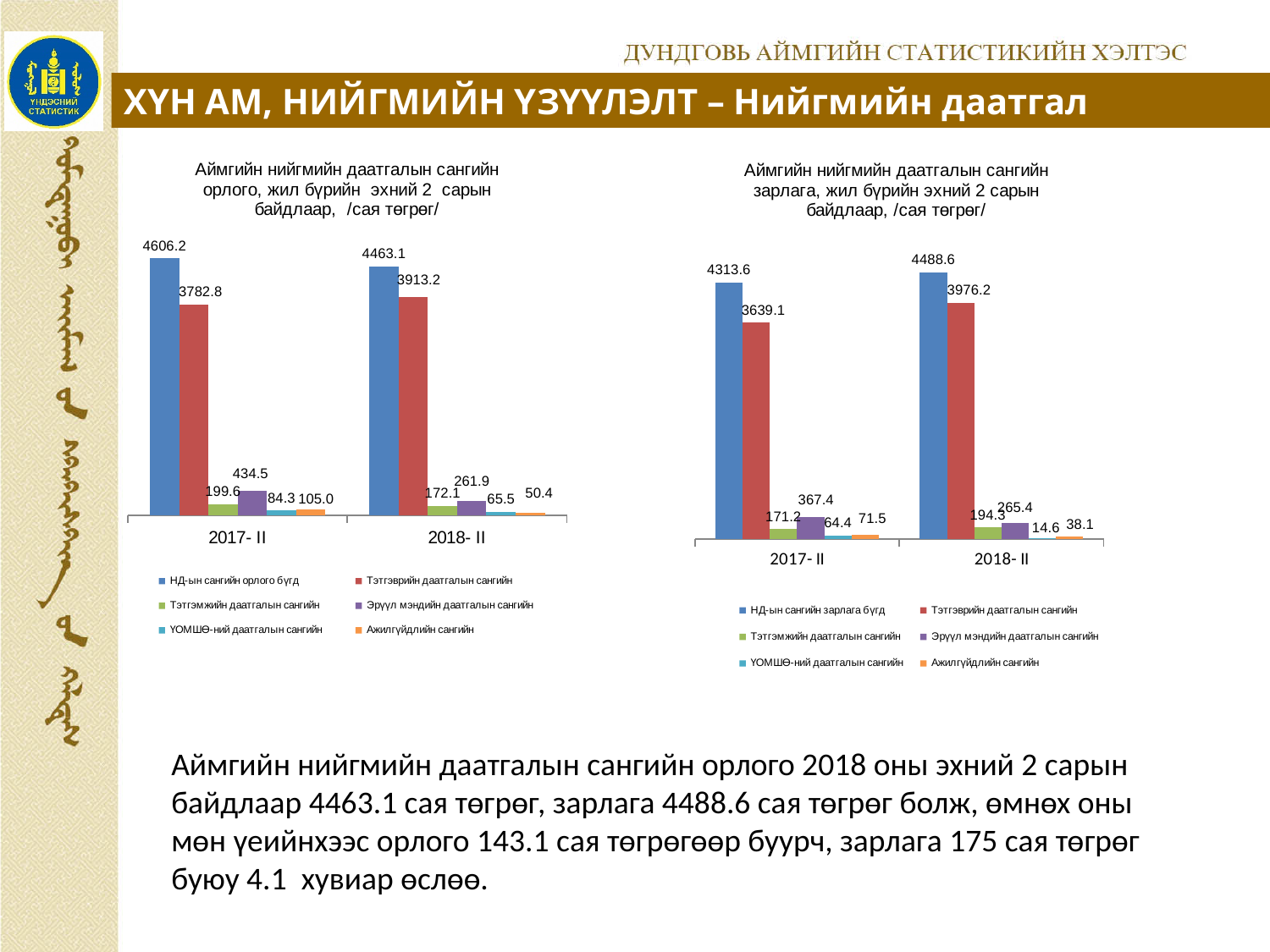
What type of chart is the left chart (Аймгийн нийгмийн даатгалын сангийн орлого)? Bar chart In the left chart (Аймгийн нийгмийн даатгалын сангийн орлого), what is the difference between НД-ын сангийн орлого бүгд in 2017-II and 2018-II? 143.1 In the right chart (Аймгийн нийгмийн даатгалын сангийн зарлага), what is the difference between НД-ын сангийн зарлага бүгд in 2018-II and 2017-II? 175 In the left chart (Аймгийн нийгмийн даатгалын сангийн орлого), what is the value of Тэтгэврийн даатгалын сангийн for 2017-II? 3782.8 In the right chart (Аймгийн нийгмийн даатгалын сангийн зарлага), what is the value of Эрүүл мэндийн даатгалын сангийн for 2017-II? 367.4 In the right chart (Аймгийн нийгмийн даатгалын сангийн зарлага), does the value of Тэтгэврийн даатгалын сангийн rise or fall from 2017-II to 2018-II? Rise In the right chart (Аймгийн нийгмийн даатгалын сангийн зарлага), what is the value of НД-ын сангийн зарлага бүгд for 2018-II? 4488.6 How many series does the legend of the right chart (Аймгийн нийгмийн даатгалын сангийн зарлага) list? 6 In the right chart (Аймгийн нийгмийн даатгалын сангийн зарлага), which series has the lowest value for 2018-II? ҮОМШӨ-ний даатгалын сангийн In the left chart (Аймгийн нийгмийн даатгалын сангийн орлого), what is the value of НД-ын сангийн орлого бүгд for 2018-II? 4463.1 In the left chart (Аймгийн нийгмийн даатгалын сангийн орлого), which is larger for 2018-II: Эрүүл мэндийн даатгалын сангийн or Тэтгэмжийн даатгалын сангийн? Эрүүл мэндийн даатгалын сангийн In the left chart (Аймгийн нийгмийн даатгалын сангийн орлого), which series has the highest value for 2017-II? НД-ын сангийн орлого бүгд